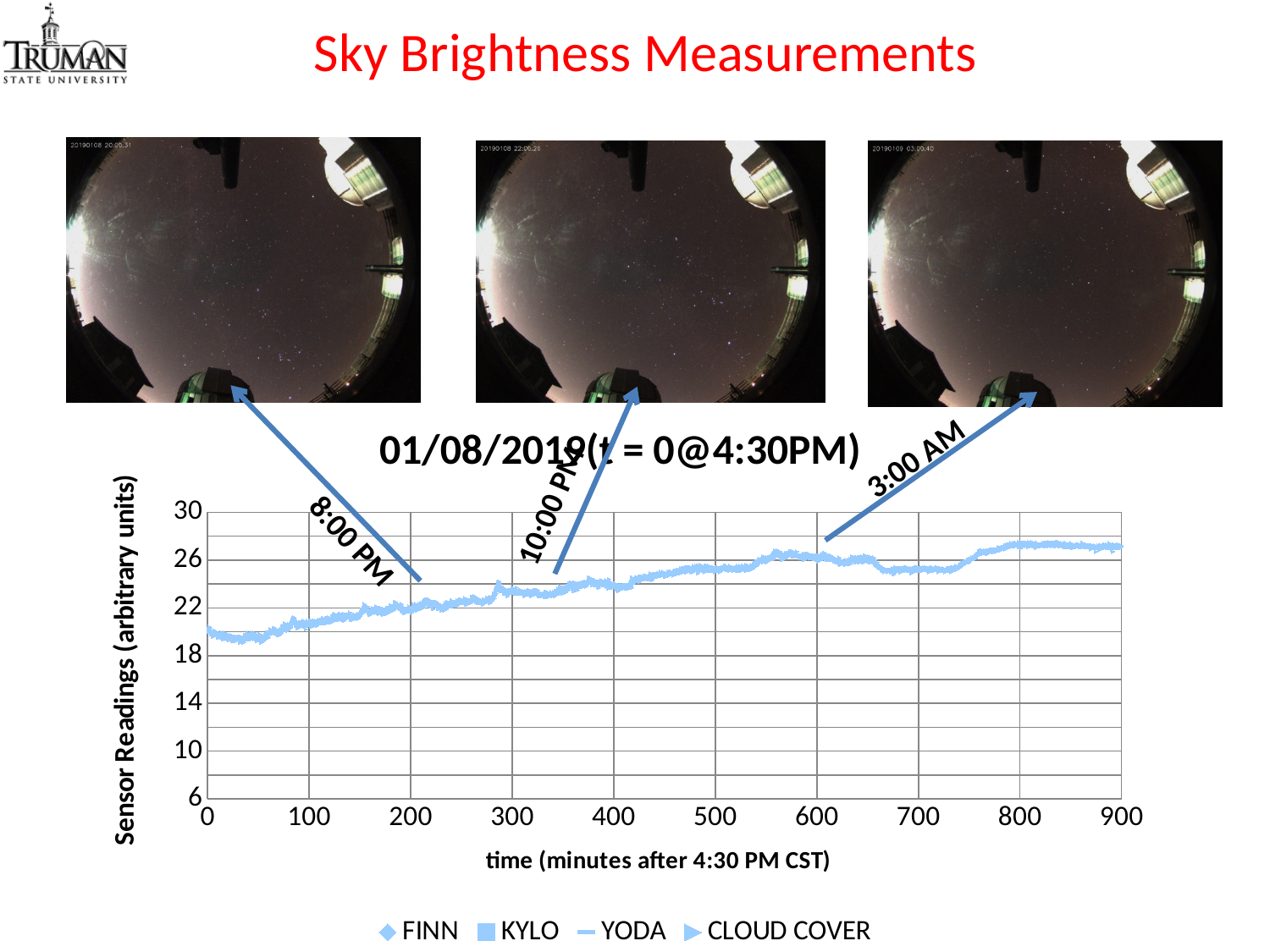
What is the title of the chart? 01/08/2019(t = 0@4:30PM) Which is larger, the sensor reading at time 200 or the sensor reading at time 600? time 600 Is the sensor reading at time 900 greater or less than 26? greater Is the sensor reading at time 400 greater or less than 22? greater Do the sensor readings generally rise or fall as time increases along the x axis? rise Is the sensor reading at time 0 greater or less than 22? less What is the highest value shown on the y axis? 30 Which is larger, the sensor reading at time 0 or the sensor reading at time 900? time 900 What is the label of the y axis? Sensor Readings (arbitrary units) How many series does the chart legend list? 4